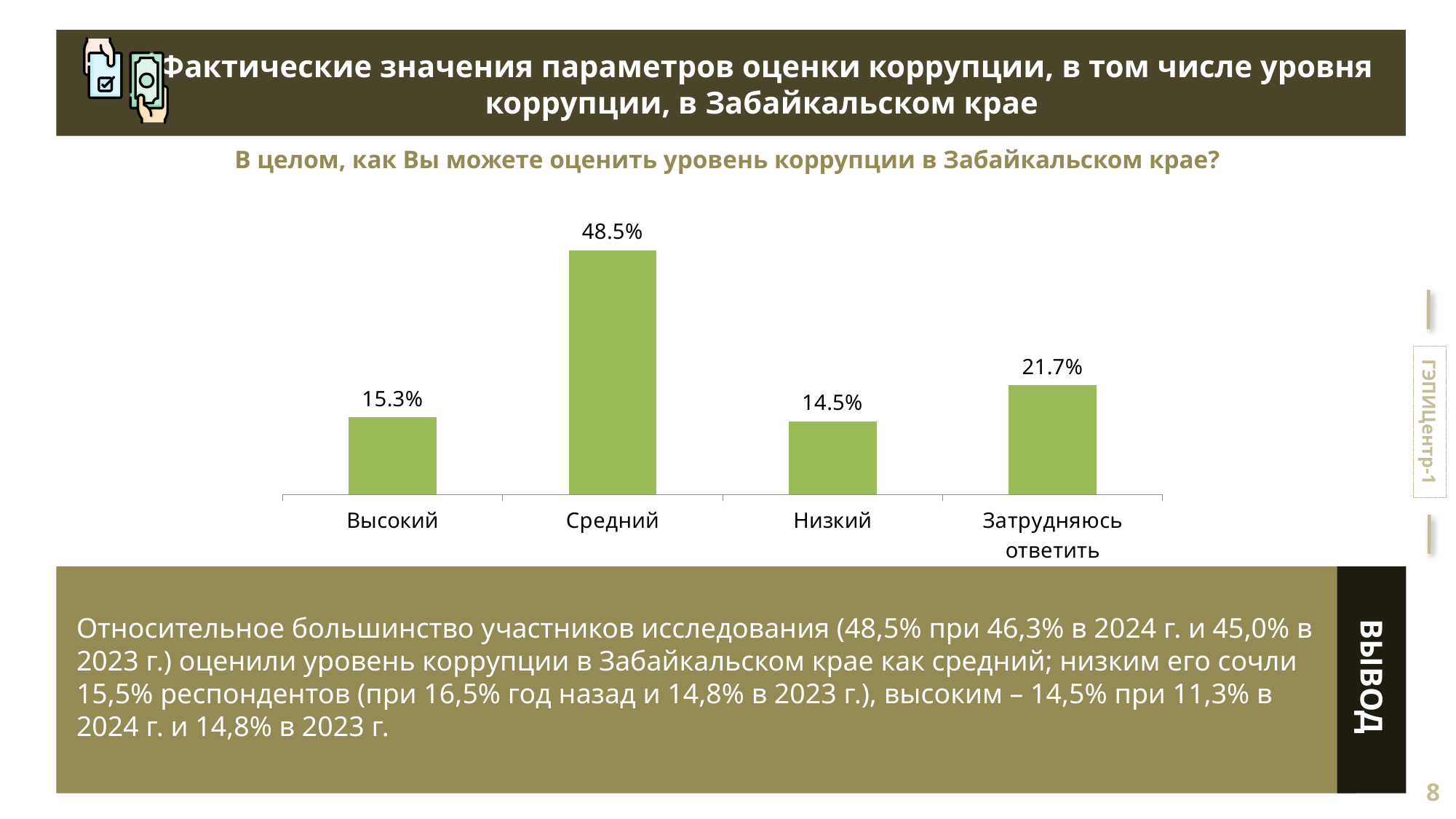
Which category has the highest value in the chart? Средний What value does the chart show for the category "Низкий"? 14.5% What value does the chart show for the category "Высокий"? 15.3% Which is larger: the value for "Затрудняюсь ответить" or the value for "Высокий"? Затрудняюсь ответить Which category has the lowest value in the chart? Низкий What is the difference between the values for "Высокий" and "Низкий"? 0.8% What question is the chart titled with? В целом, как Вы можете оценить уровень коррупции в Забайкальском крае? What type of chart is shown on the slide? Bar chart What is the difference between the values for "Средний" and "Затрудняюсь ответить"? 26.8% How many categories are shown in the chart? 4 What value does the chart show for the category "Средний"? 48.5% What value does the chart show for the category "Затрудняюсь ответить"? 21.7%